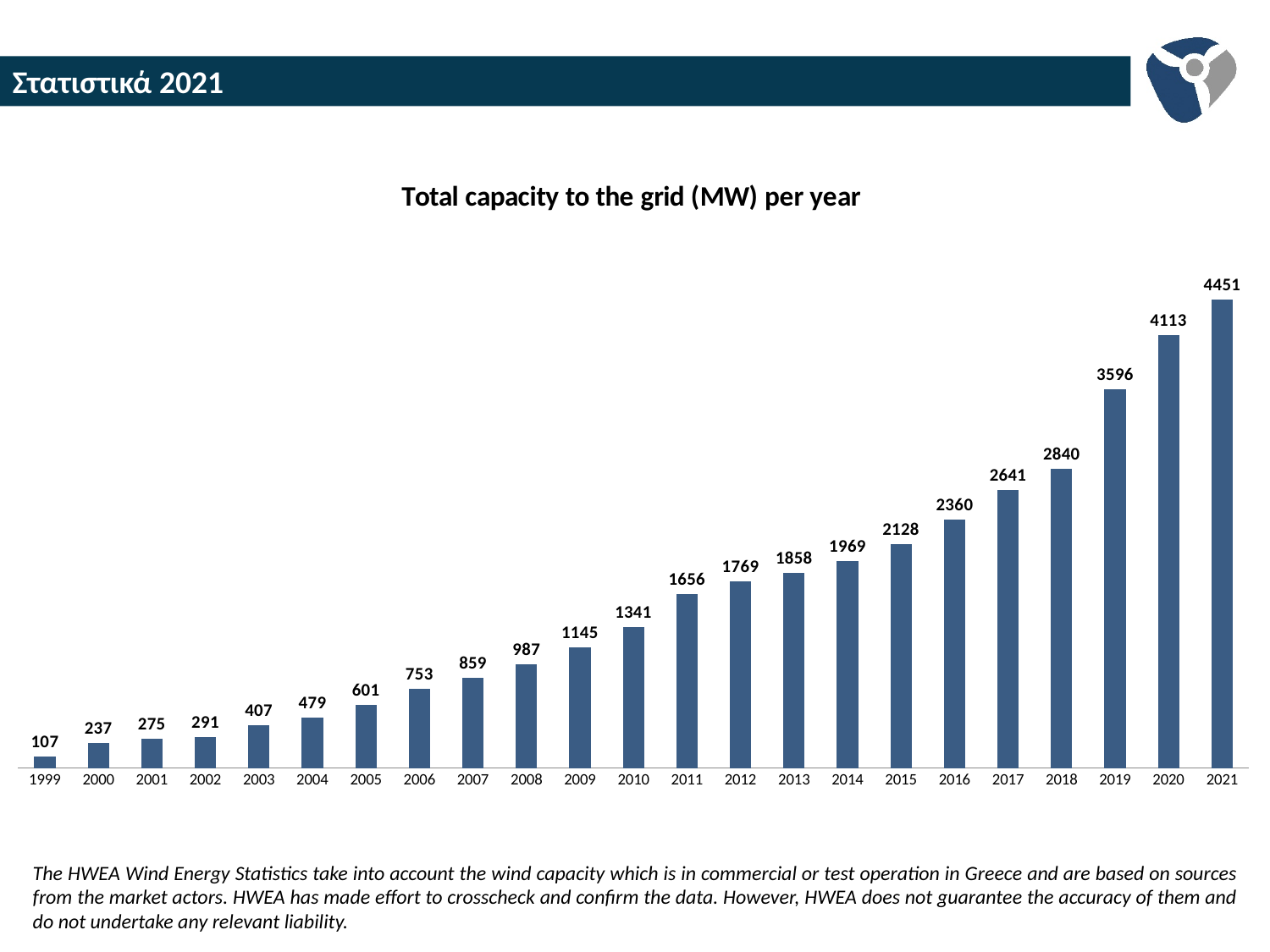
What is the total capacity to the grid in 2021? 4451 What is the title of the chart? Total capacity to the grid (MW) per year What is the total capacity to the grid in 1999? 107 What is the total capacity to the grid in 2010? 1341 How many years are shown on the x axis of the chart? 23 What is the difference in total capacity between 2019 and 2018? 756 What is the difference in total capacity between 2021 and 2020? 338 Which year has a larger total capacity, 2005 or 2008? 2008 Which year has the highest total capacity to the grid? 2021 Which year has the lowest total capacity to the grid? 1999 Do the values rise or fall from 1999 to 2021? Rise What kind of chart is shown on the slide? Bar chart